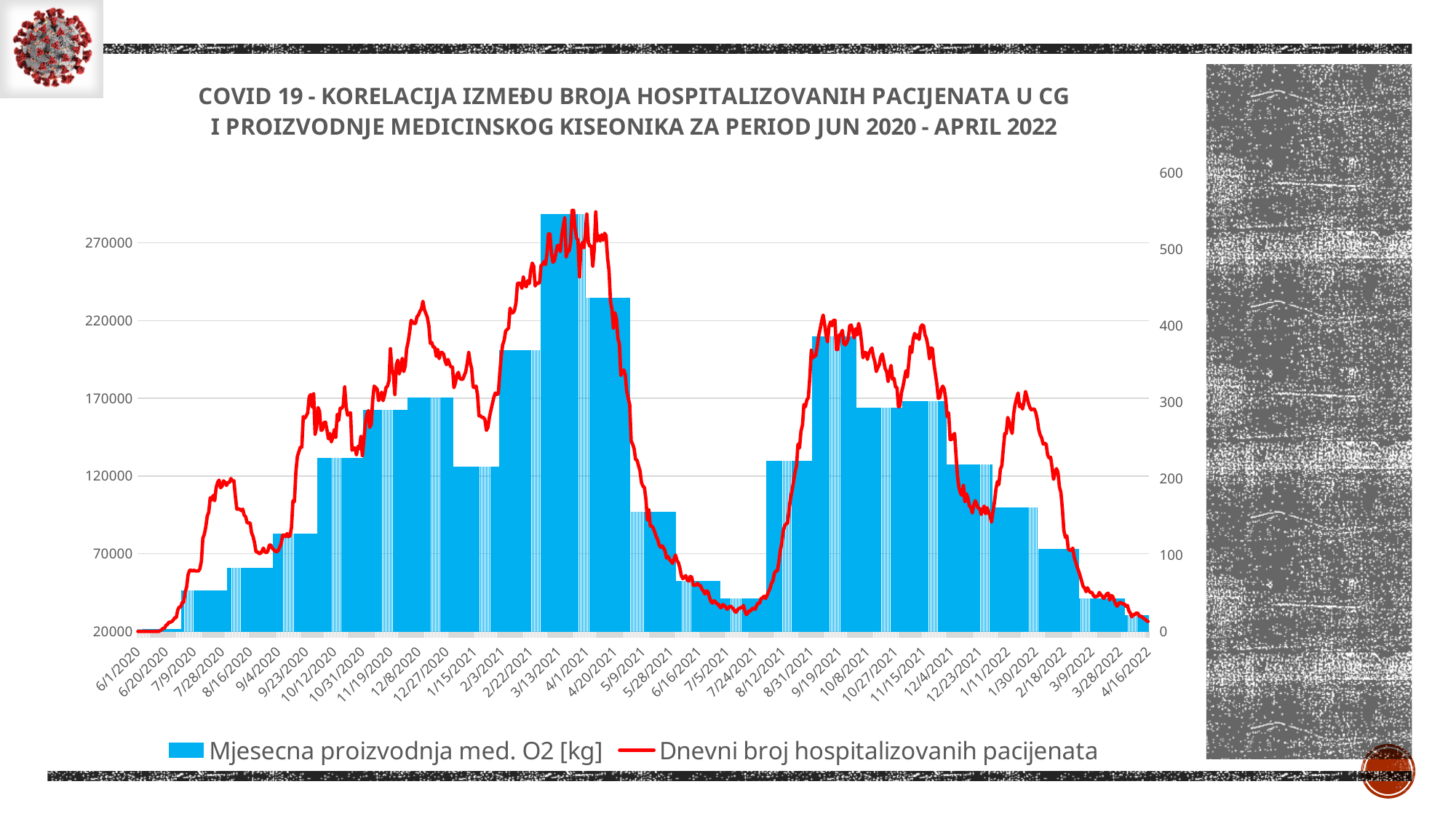
Do the bars rise or fall between 7/24/2021 and 9/19/2021? rise How many series does the legend list? 2 Which series is drawn as blue bars? Mjesecna proizvodnja med. O2 [kg] What kind of chart is shown on the slide? A combination bar and line chart Is the bar around 3/13/2021 taller or shorter than the bar around 9/19/2021? taller Which series is drawn as a red line? Dnevni broj hospitalizovanih pacijenata Is the red line value at 4/16/2022 greater or less than 100 on the right axis? less Is the tallest bar (around 3/13/2021) greater or less than 270000 on the left axis? greater Do the bars rise or fall between 3/13/2021 and 7/5/2021? fall Is the bar around 7/5/2021 greater or less than 70000 on the left axis? less